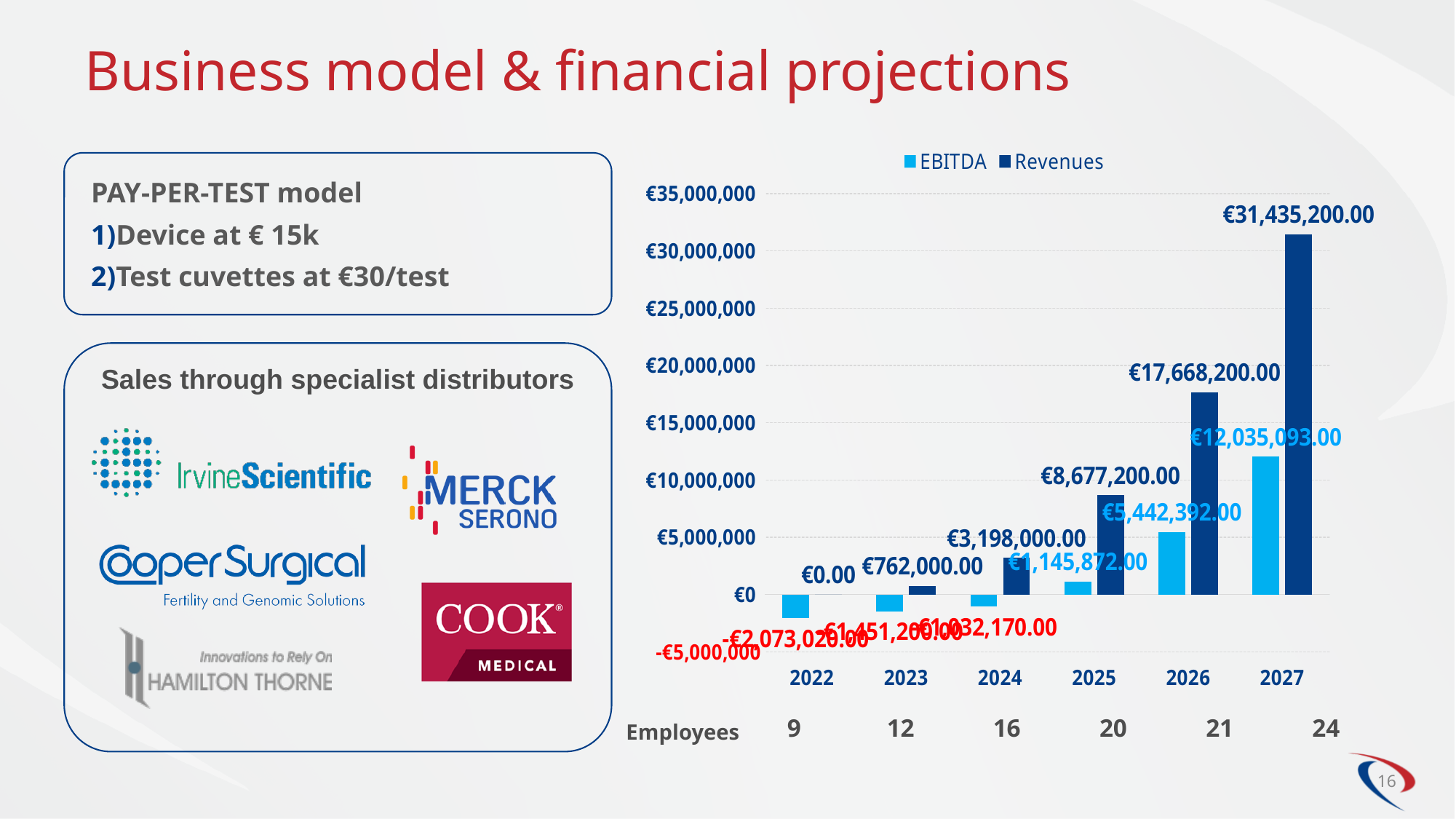
Which year has the highest Revenues? 2027 Is the EBITDA value for 2022 greater or less than €0? less What is the Revenues value for 2023? €762,000.00 What is the EBITDA value for 2027? €12,035,093.00 Do the Revenues values rise or fall from 2022 to 2027? Rise What is the difference between Revenues in 2027 and Revenues in 2026? €13,767,000.00 What is the Revenues value for 2025? €8,677,200.00 What is the EBITDA value for 2026? €5,442,392.00 How many series does the legend list? 2 What is the Revenues value for 2027? €31,435,200.00 What kind of chart is shown on the slide? Bar chart How many years are shown on the x axis of the chart? 6